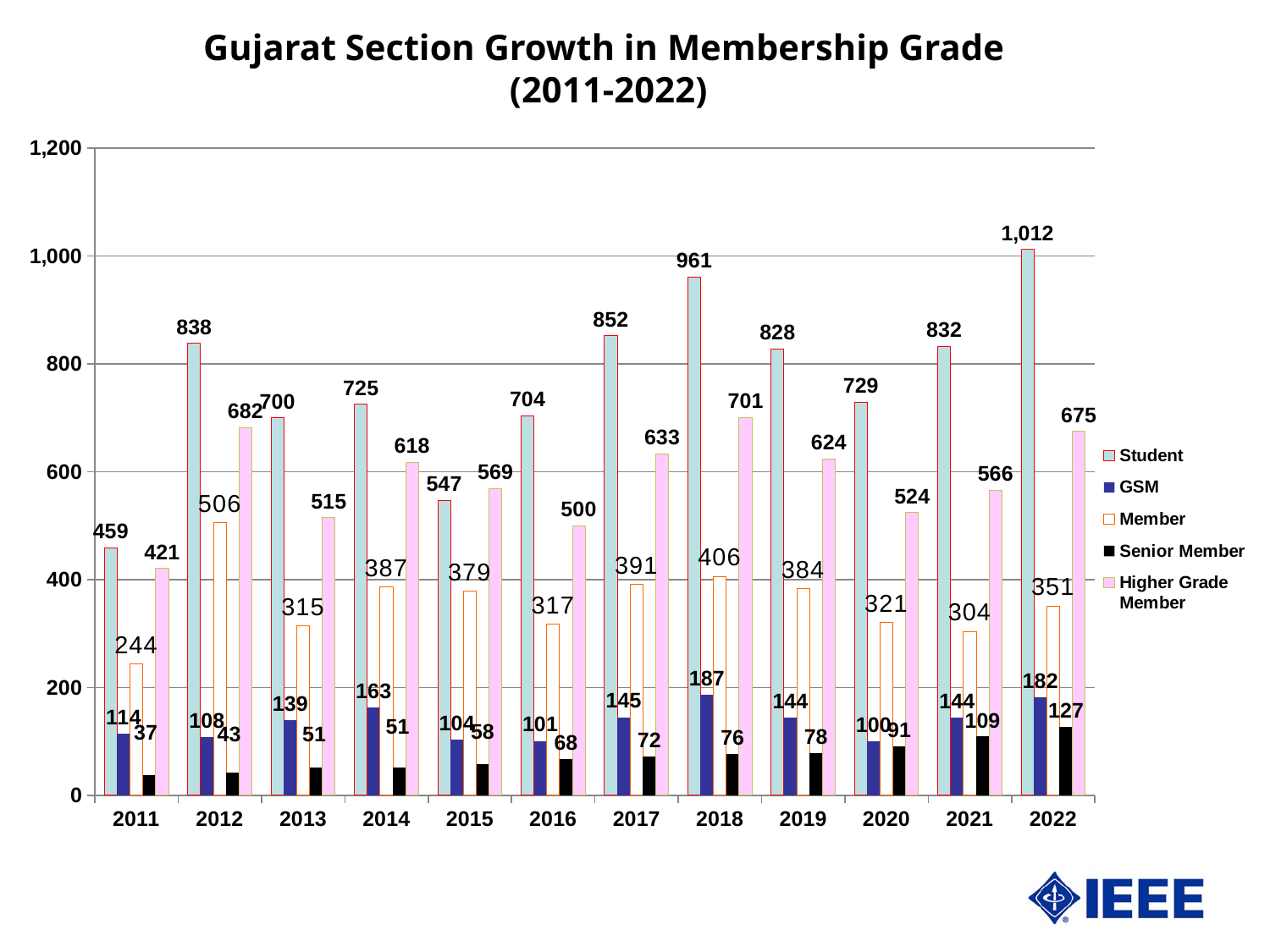
Which is larger, the Higher Grade Member value for 2012 or for 2022? 2012 What is the difference between the Student values for 2018 and 2017? 109 What is the value for Student in 2022? 1,012 In which year is the Student value highest? 2022 What kind of chart is shown on the slide? bar chart In which year is the Senior Member value lowest? 2011 What is the value for Member in 2018? 406 How many years are shown on the x axis? 12 How many series does the legend list? 5 Is the Student value for 2015 greater or less than 600? less What is the value for Senior Member in 2020? 91 Do the Senior Member values generally rise or fall from 2011 to 2022? rise